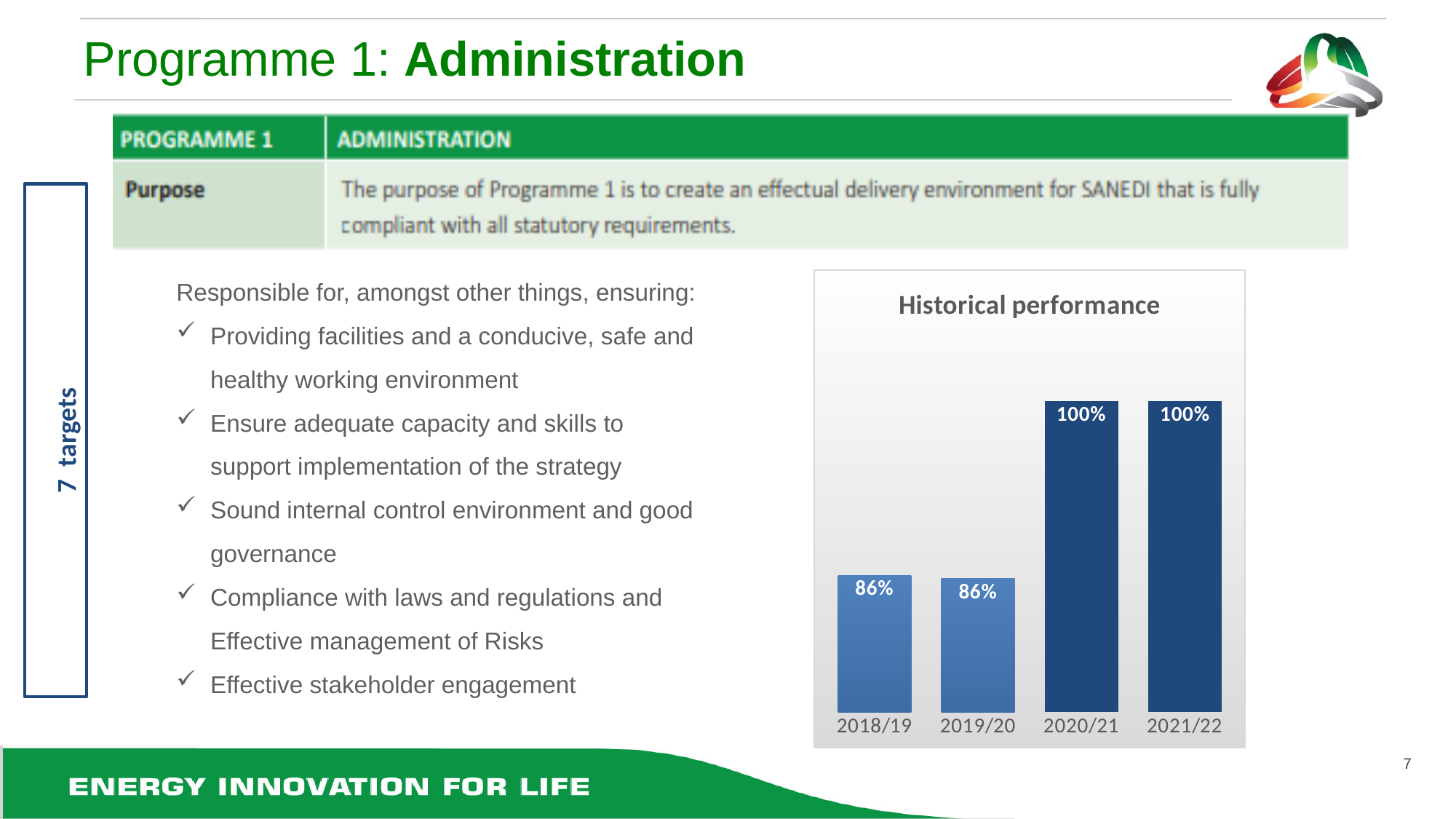
Which is larger in the Historical performance chart, the value for 2019/20 or the value for 2021/22? 2021/22 How many years are shown in the Historical performance chart? 4 What kind of chart is the Historical performance chart? Bar chart Which year has the lowest value in the Historical performance chart, 2019/20 or 2020/21? 2019/20 Do the values in the Historical performance chart rise or fall from 2018/19 to 2021/22? Rise What is the difference between the values for 2020/21 and 2018/19 in the Historical performance chart? 14% Which years in the Historical performance chart have the same value of 100%? 2020/21 and 2021/22 What is the value for 2020/21 in the Historical performance chart? 100% What is the value for 2018/19 in the Historical performance chart? 86% What is the value for 2021/22 in the Historical performance chart? 100% What is the value for 2019/20 in the Historical performance chart? 86% What is the title of the chart on the slide? Historical performance